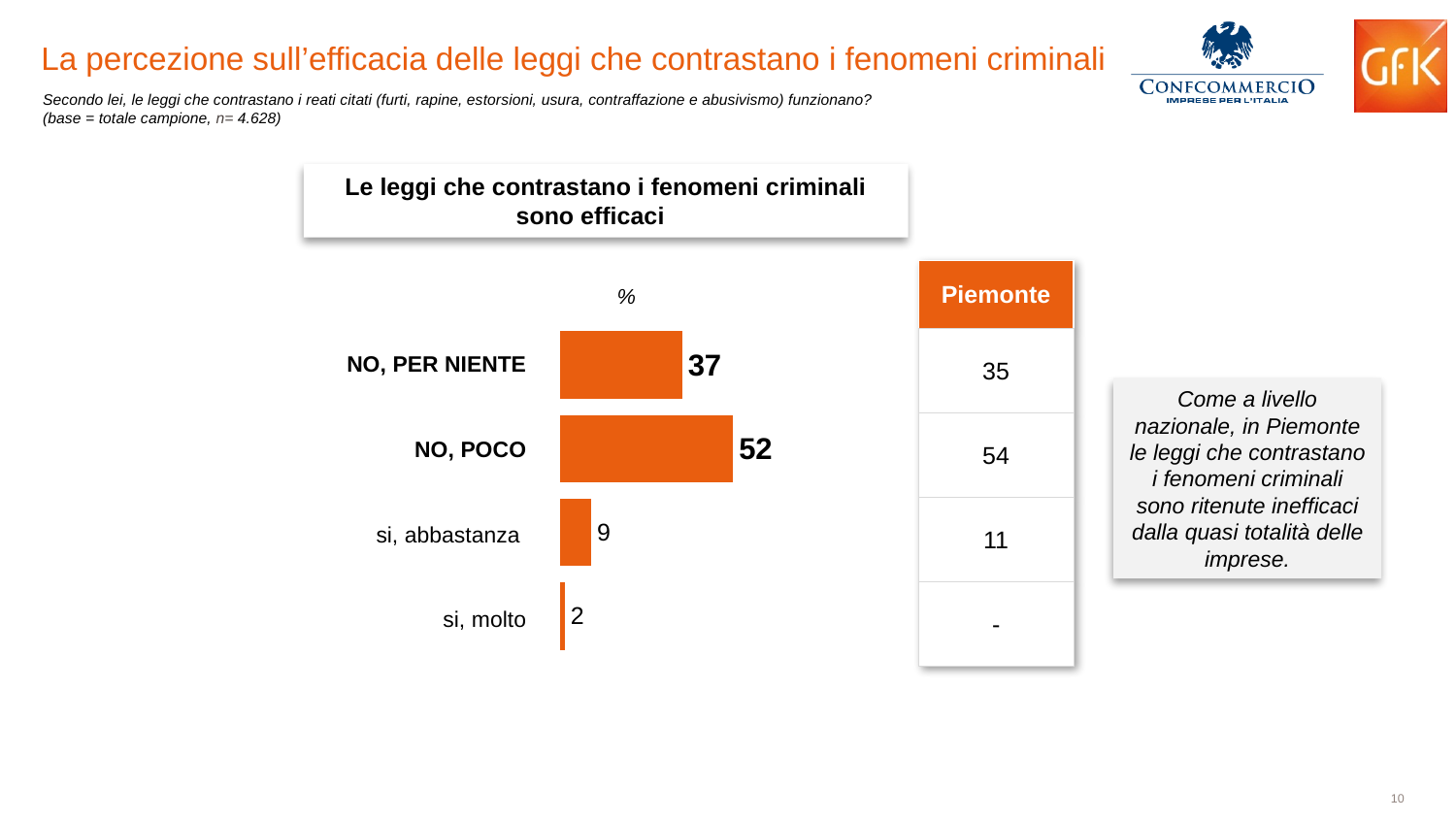
What is the difference between the values for NO, POCO and NO, PER NIENTE? 15 What kind of chart is shown on the slide? Bar chart What is the value for NO, PER NIENTE in the chart? 37 What is the title of the chart? Le leggi che contrastano i fenomeni criminali sono efficaci Which category has the highest value in the chart? NO, POCO Which category has the lowest value in the chart? si, molto What is the sum of the values for si, abbastanza and si, molto? 11 Which is larger, the value for NO, PER NIENTE or the value for si, abbastanza? NO, PER NIENTE How many categories are shown in the chart? 4 What is the value for si, abbastanza in the chart? 9 What is the value for NO, POCO in the chart? 52 What is the value for si, molto in the chart? 2